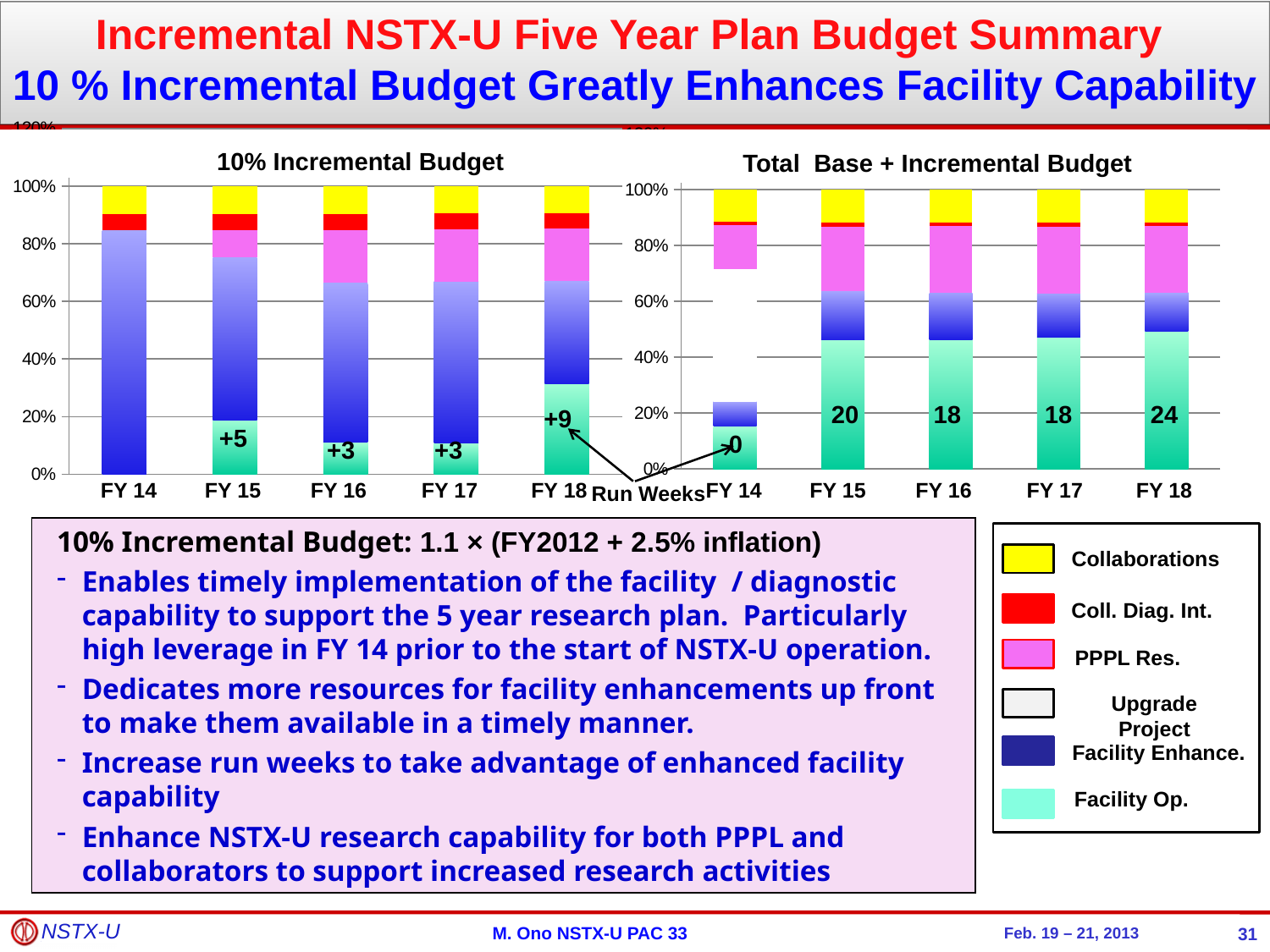
How many fiscal-year categories are shown on the x axis of the 'Total Base + Incremental Budget' chart? 5 In the 'Total Base + Incremental Budget' chart, what run-weeks value is labelled on the FY 15 bar? 20 In the 'Total Base + Incremental Budget' chart, what is the difference between the run-weeks labels for FY 18 and FY 16? 6 In the '10% Incremental Budget' chart, what run-weeks label is shown on the FY 15 bar? +5 What is the title of the chart on the right side of the slide? Total Base + Incremental Budget How many entries does the legend on the slide list? 6 In the '10% Incremental Budget' chart, what run-weeks label is shown on the FY 18 bar? +9 In the 'Total Base + Incremental Budget' chart, which fiscal year has the lowest labelled run-weeks value? FY 14 In the '10% Incremental Budget' chart, which has the larger run-weeks label, FY 15 or FY 16? FY 15 What kind of chart is the '10% Incremental Budget' chart? Stacked bar chart In the 'Total Base + Incremental Budget' chart, which fiscal year has the highest labelled run-weeks value? FY 18 In the 'Total Base + Incremental Budget' chart, what run-weeks value is labelled on the FY 18 bar? 24